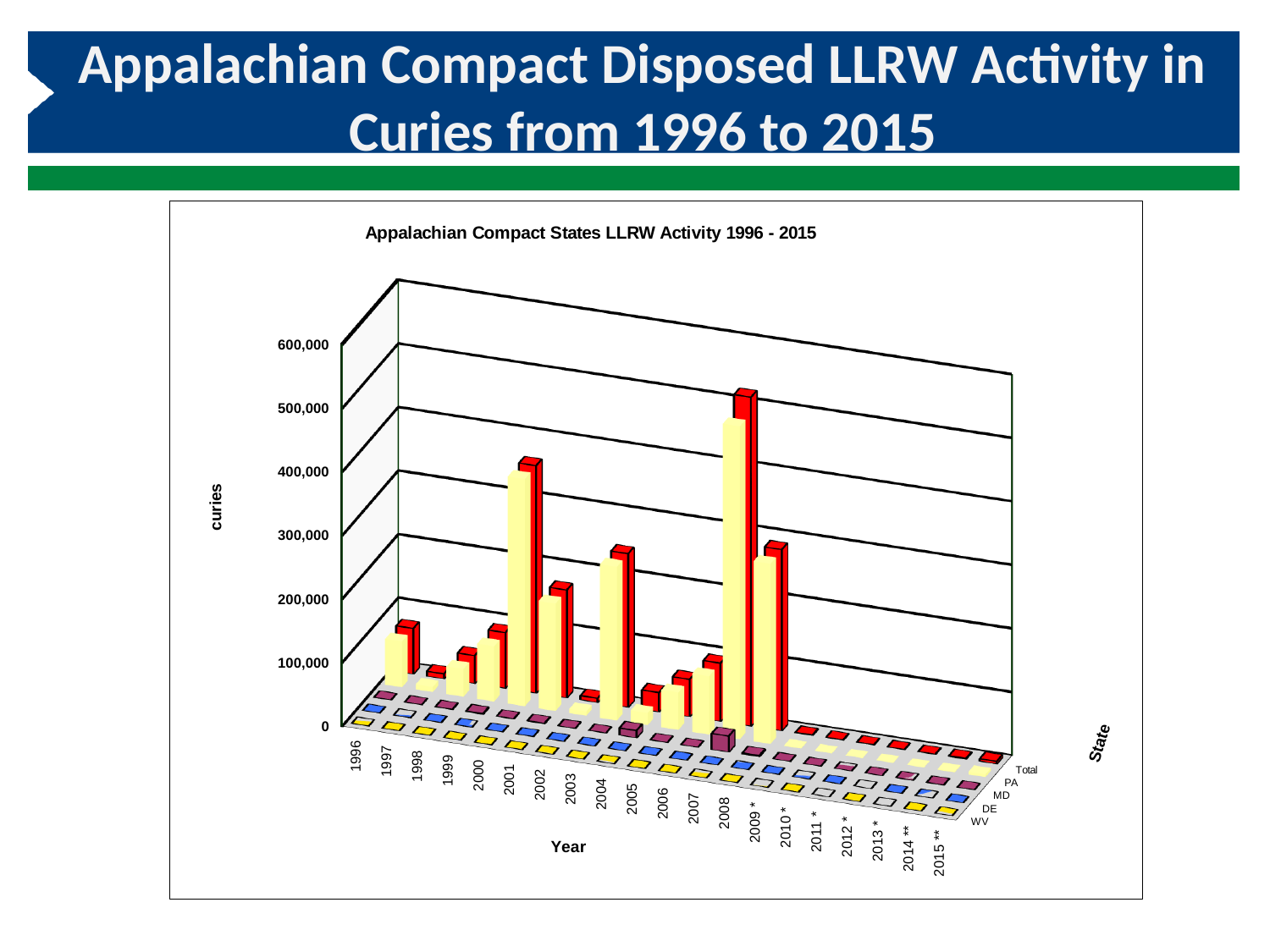
Which year has the highest Total bar in the chart? 2007 What is the label on the vertical axis of the chart? curies Which year has the larger Total bar, 2002 or 2004? 2004 How many state series are listed along the State axis of the chart? 5 Is the Total bar for 2003 greater or less than 100,000 curies? greater Which year has the larger Total bar, 2001 or 2008? 2008 What kind of chart is shown on the slide? bar chart How many years are shown along the Year axis of the chart? 20 What is the title printed inside the chart area? Appalachian Compact States LLRW Activity 1996 - 2015 Is the Total bar for 2009 greater or less than 200,000 curies? less